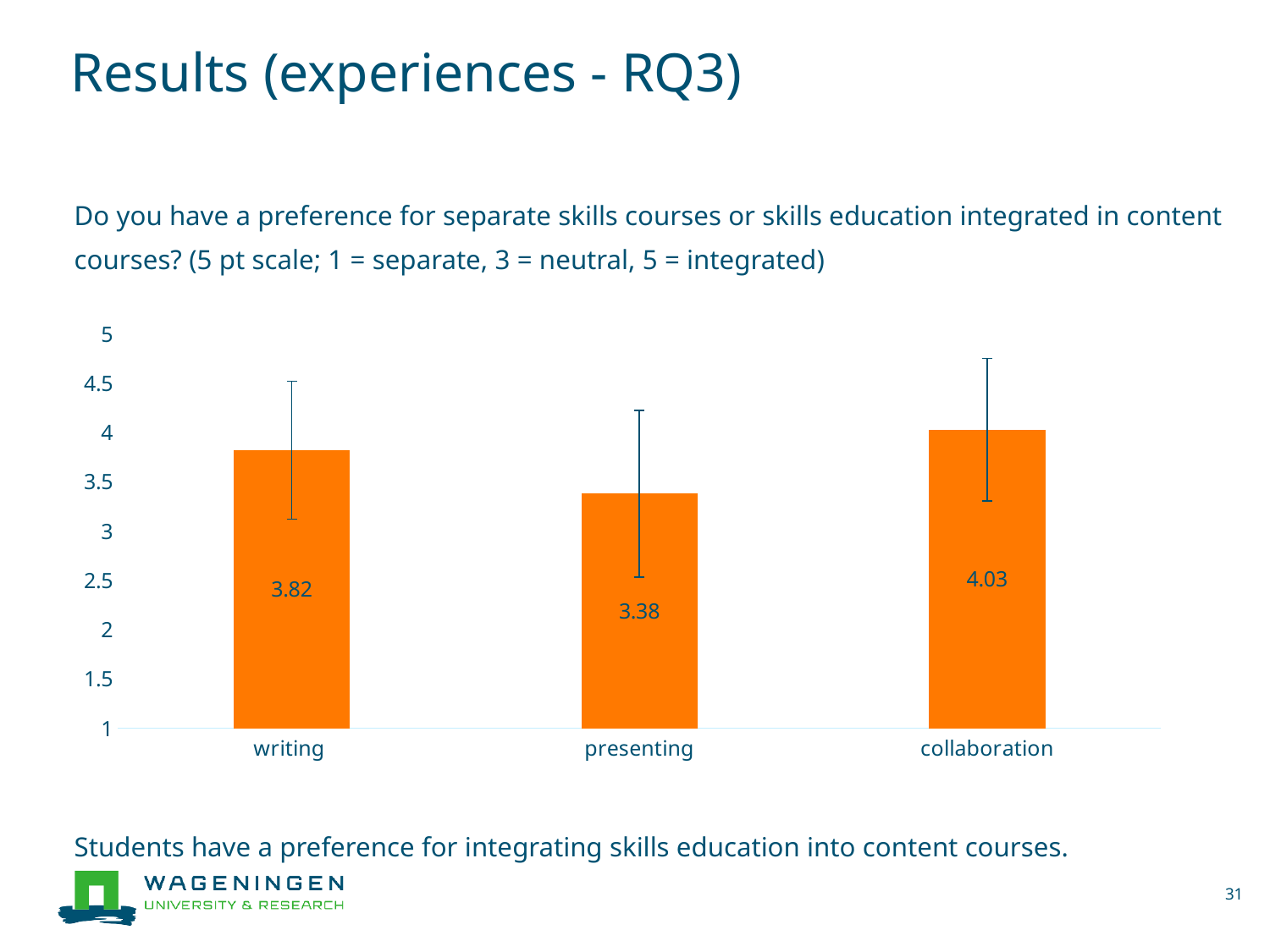
How many categories are shown on the x axis? 3 What is the value for collaboration? 4.03 Which category has the lowest value? presenting Which category has the highest value? collaboration What is the value for presenting? 3.38 What is the value for writing? 3.82 What is the difference between the values for collaboration and presenting? 0.65 Is the value for presenting greater or less than 3.5? less What colour are the bars in the chart? orange Which is larger, the value for writing or the value for collaboration? collaboration What is the difference between the values for writing and presenting? 0.44 What kind of chart is shown on the slide? bar chart